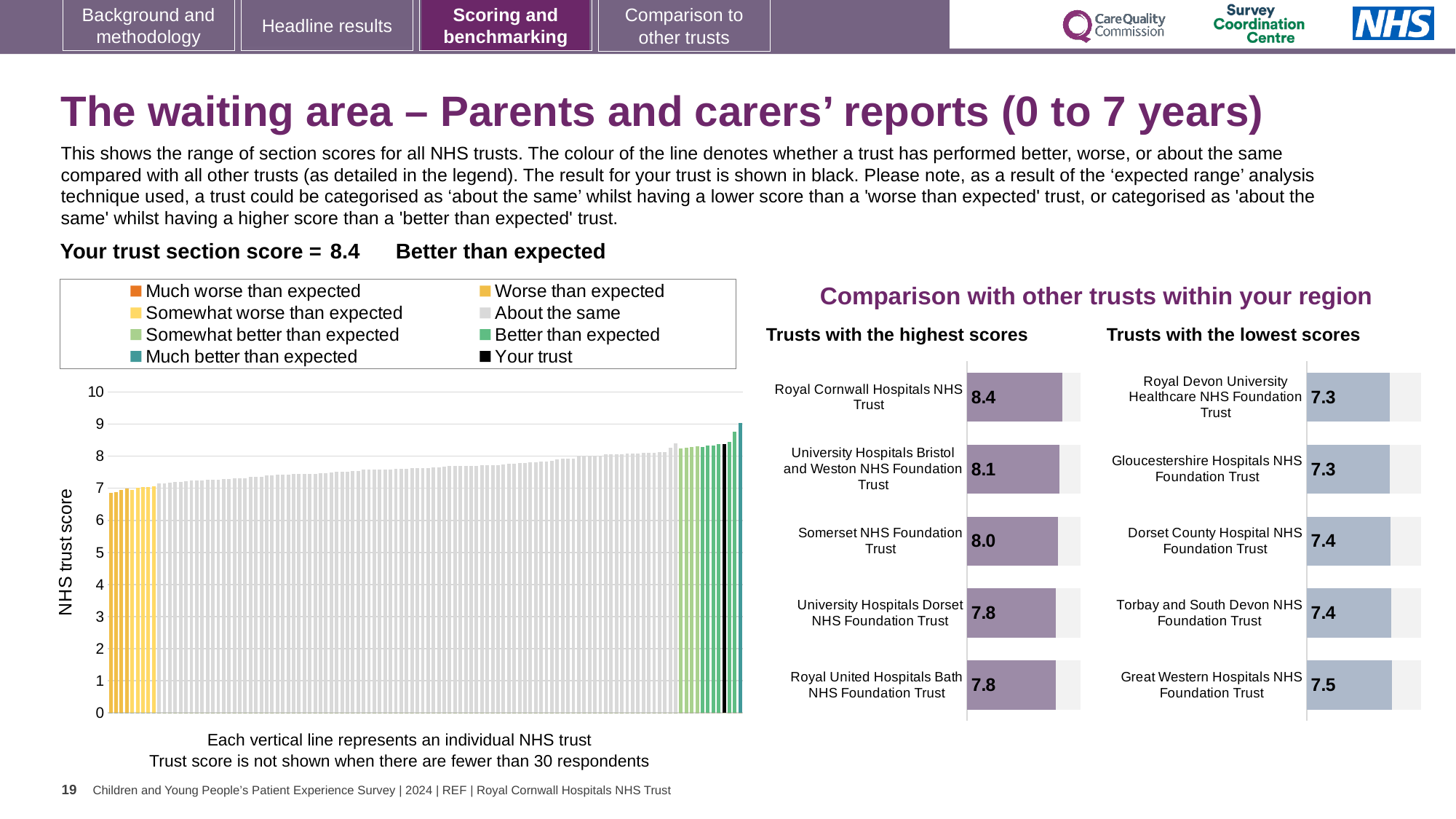
How many trusts are shown in the 'Trusts with the highest scores' chart? 5 In the 'Trusts with the lowest scores' chart, what is the score for Great Western Hospitals NHS Foundation Trust? 7.5 In the main NHS trust score chart on the left, do the bar values rise or fall from left to right? Rise How many entries does the legend of the main NHS trust score chart on the left list? 8 In the 'Trusts with the highest scores' chart, what is the difference between the scores of Royal Cornwall Hospitals NHS Trust and Royal United Hospitals Bath NHS Foundation Trust? 0.6 In the 'Trusts with the highest scores' chart, which has the larger score: Somerset NHS Foundation Trust or University Hospitals Dorset NHS Foundation Trust? Somerset NHS Foundation Trust In the 'Trusts with the highest scores' chart, which trust has the highest score? Royal Cornwall Hospitals NHS Trust In the 'Trusts with the highest scores' chart, what is the score for Somerset NHS Foundation Trust? 8.0 In the main NHS trust score chart on the left, is the value of the tallest bar greater or less than 8? greater What is the y-axis label of the main chart on the left? NHS trust score In the 'Trusts with the lowest scores' chart, what is the difference between the scores of Great Western Hospitals NHS Foundation Trust and Royal Devon University Healthcare NHS Foundation Trust? 0.2 What kind of chart is the main NHS trust score chart on the left? Bar chart